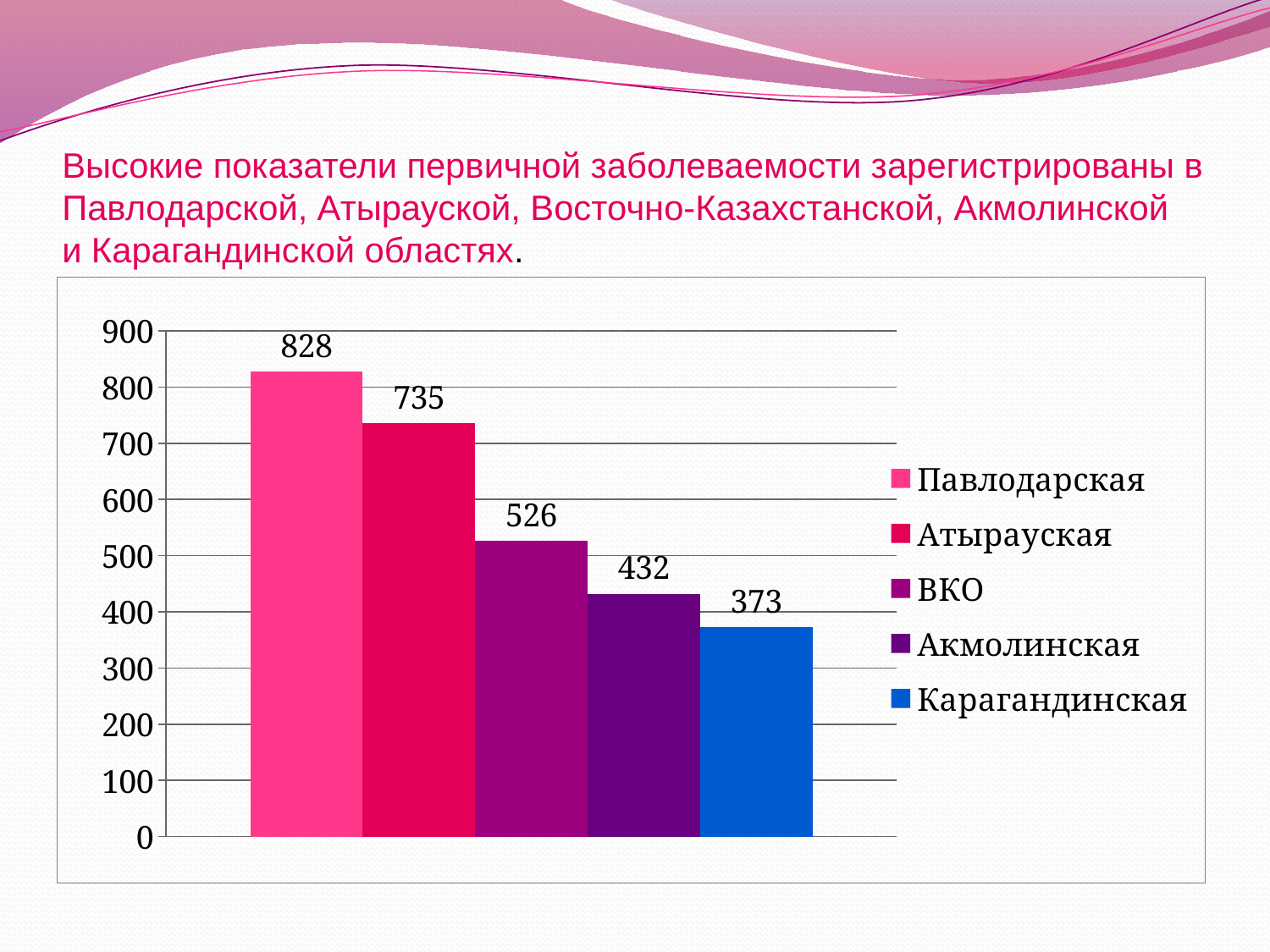
Which is larger, the value for ВКО or the value for Акмолинская? ВКО What is the value for Акмолинская? 432 Which region has the highest value? Павлодарская What is the difference between the values for Павлодарская and Атырауская? 93 Do the values rise or fall from left to right across the bars? fall How many series does the legend list? 5 What is the value for Павлодарская? 828 What kind of chart is shown on the slide? bar chart What is the value for Карагандинская? 373 What is the value for Атырауская? 735 What is the value for ВКО? 526 Which region has the lowest value? Карагандинская